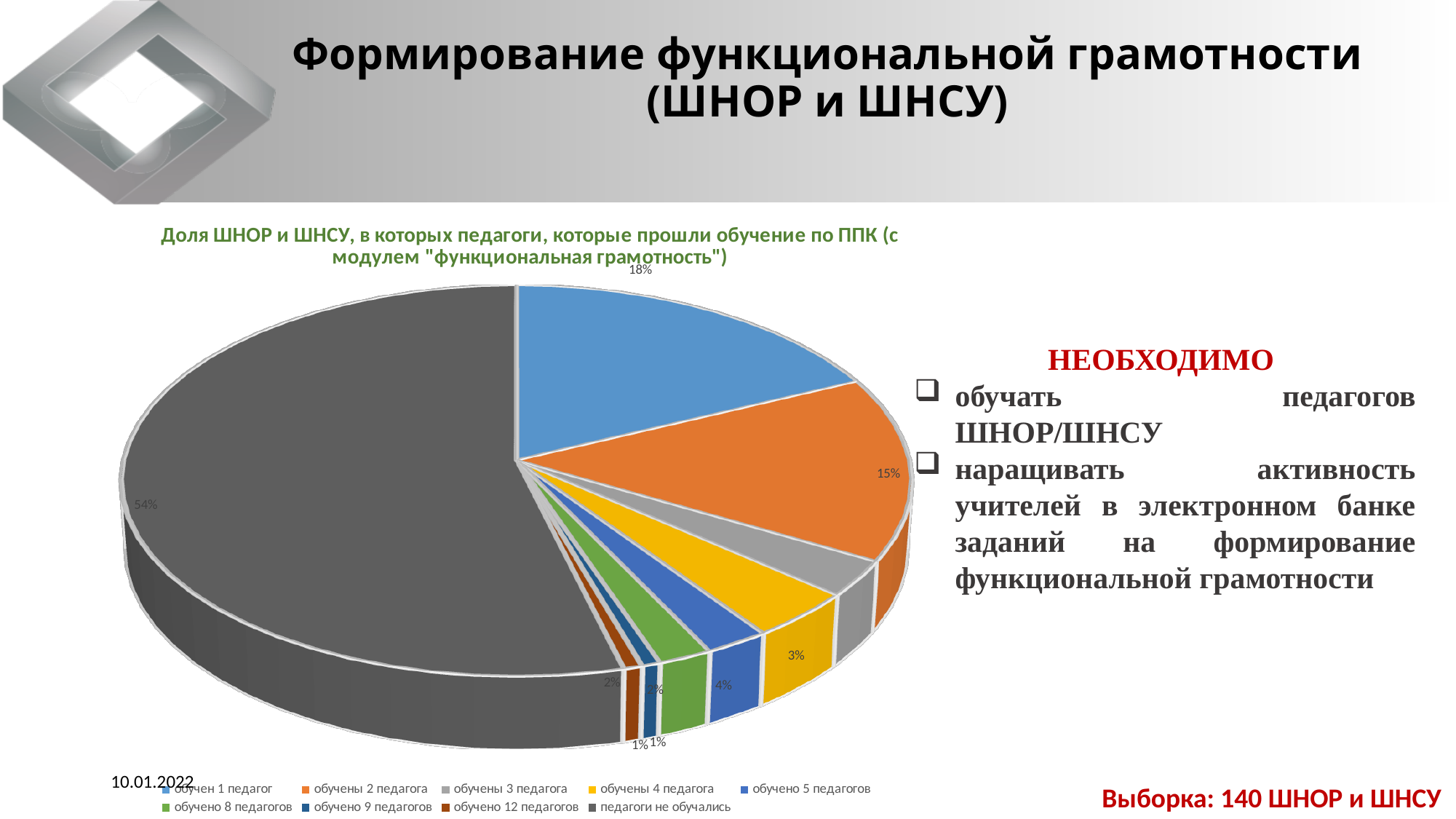
What is the combined share of "педагоги не обучались", "обучен 1 педагог" and "обучены 2 педагога"? 87% What percentage is shown for "обучены 2 педагога"? 15% Which category has the largest slice of the pie? педагоги не обучались What share of the pie is labelled for "педагоги не обучались"? 54% Which is larger: the slice for "обучен 1 педагог" or the slice for "обучены 2 педагога"? обучен 1 педагог What percentage is shown for "обучен 1 педагог"? 18% How many categories does the legend of the pie chart list? 9 Is the share for "педагоги не обучались" greater or less than half of the pie? greater What kind of chart is shown on the slide? pie chart What is the difference in percentage points between "педагоги не обучались" and "обучен 1 педагог"? 36% What is the difference in percentage points between "обучен 1 педагог" and "обучены 2 педагога"? 3% What colour is the slice for "педагоги не обучались"? dark gray